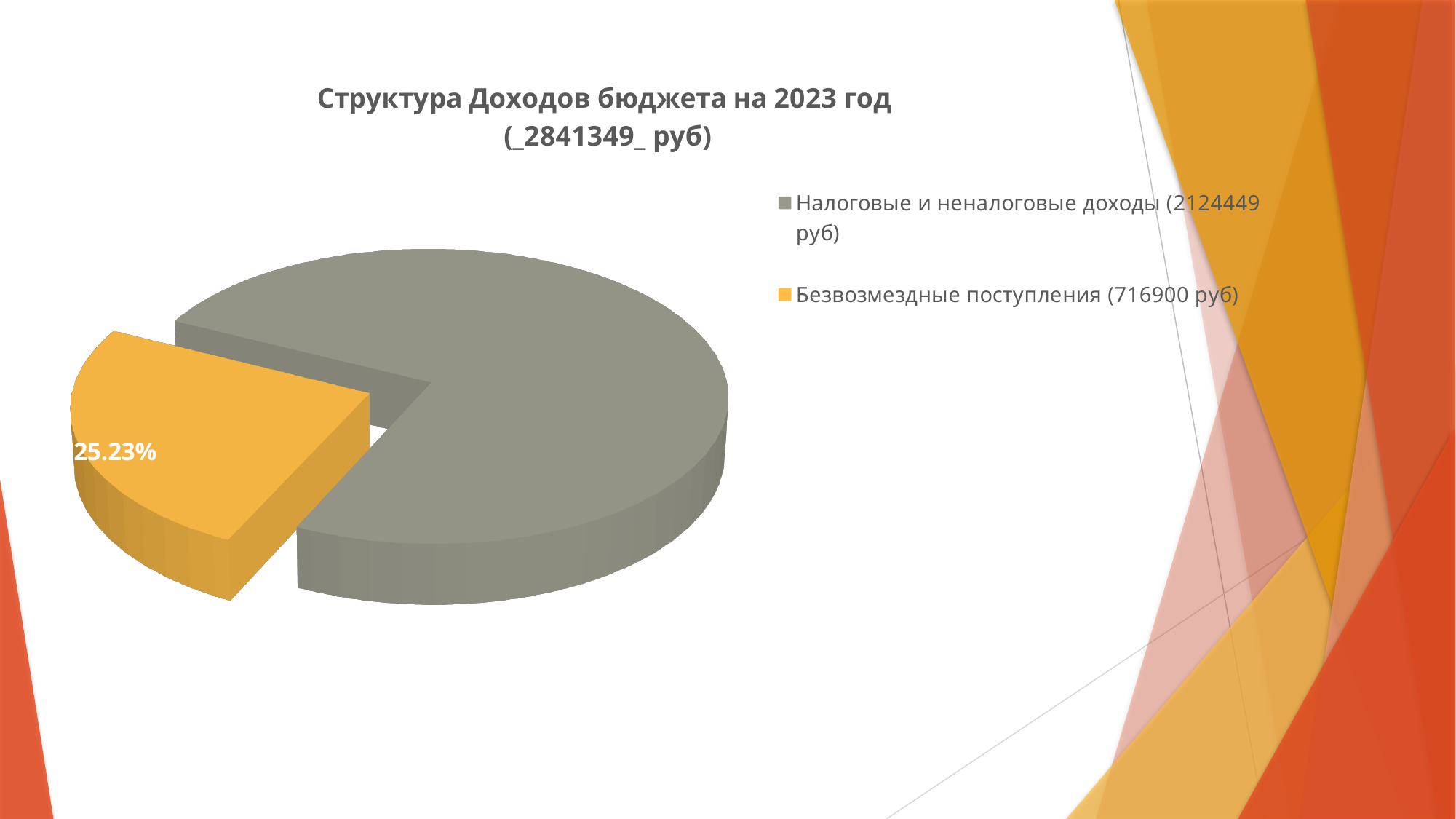
Which category has the smallest slice of the pie? Безвозмездные поступления What percentage share is labelled on the slice for Безвозмездные поступления? 25.23% What colour is the slice for Безвозмездные поступления? orange Which category has the largest slice of the pie? Налоговые и неналоговые доходы Which is larger: Налоговые и неналоговые доходы or Безвозмездные поступления? Налоговые и неналоговые доходы What is the title of the chart? Структура Доходов бюджета на 2023 год (_2841349_ руб) What is the difference in rubles between Налоговые и неналоговые доходы and Безвозмездные поступления? 1407549 руб What amount in rubles is given in the legend for Налоговые и неналоговые доходы? 2124449 руб How many entries does the legend list? 2 How many slices does the pie chart have? 2 What amount in rubles is given in the legend for Безвозмездные поступления? 716900 руб What kind of chart is shown on the slide? pie chart